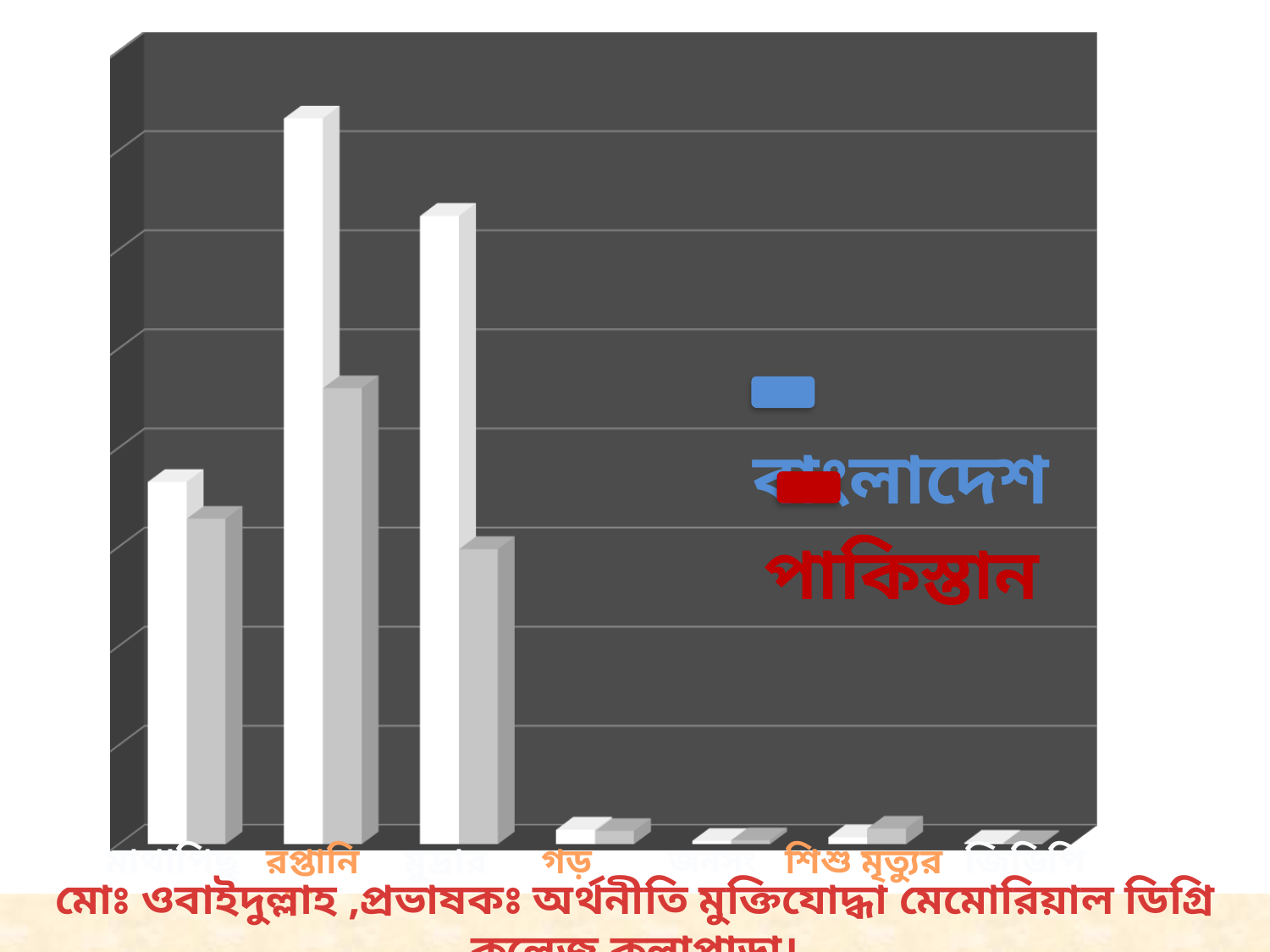
What kind of chart is shown on the slide? bar chart What are the two series names listed in the legend? বাংলাদেশ and পাকিস্তান How many categories are shown along the x axis of the chart? 7 Which of the two categories, রপ্তানি or মাথাপিছু, has the taller first bar? রপ্তানি Which legend entry is shown in blue? বাংলাদেশ Which category has the tallest bar in the chart? রপ্তানি Which of the two categories, রপ্তানি or গড়, has the taller bars? রপ্তানি Which of the two categories, শিশু মৃত্যুর or রপ্তানি, has the shorter bars? শিশু মৃত্যুর How many series does the legend list? 2